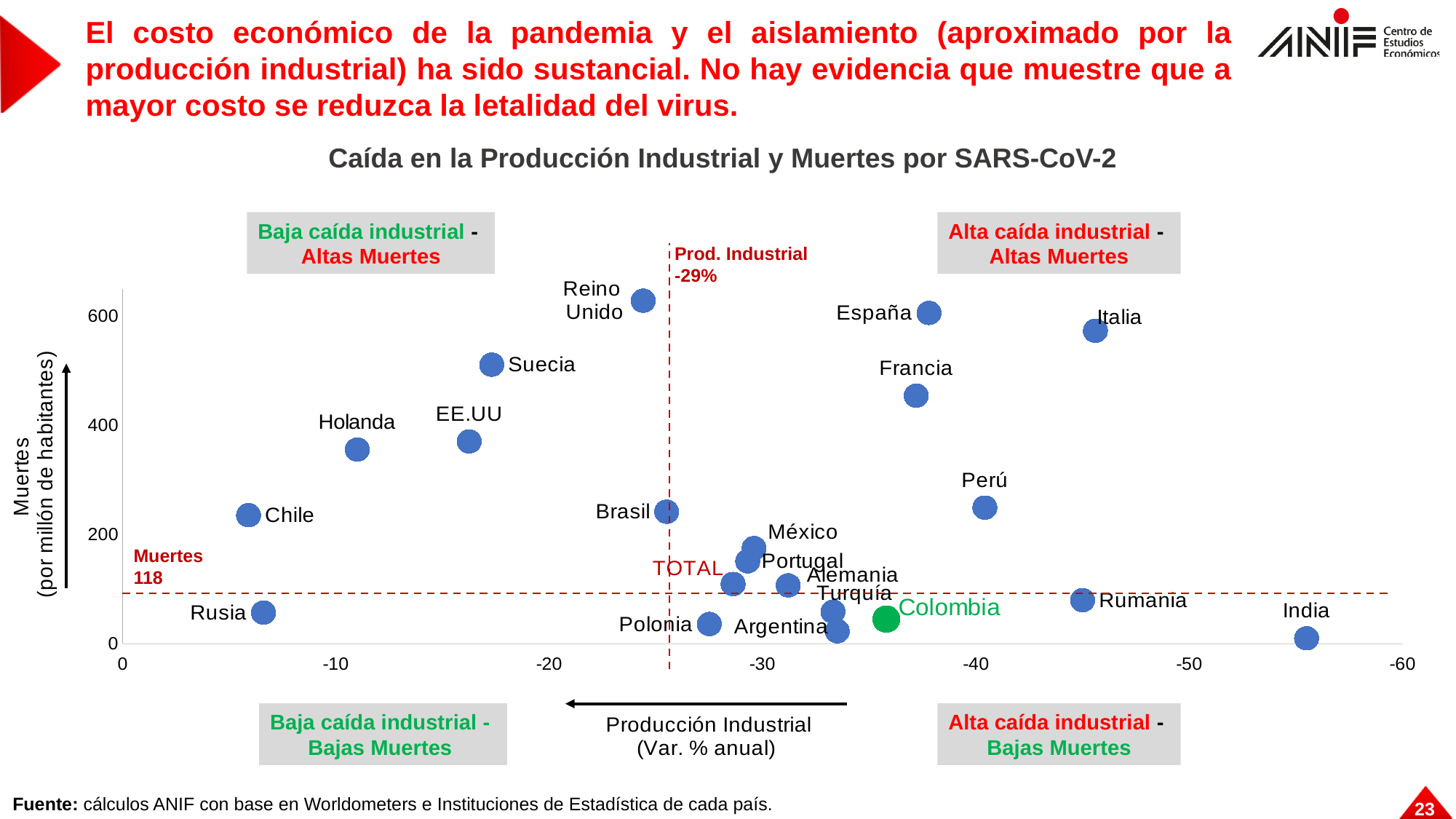
Is the deaths value for Italia greater or less than 400? greater Which country shows the largest fall in industrial production (furthest right on the x axis)? India Which has more deaths per million inhabitants, Italia or Francia? Italia Is the deaths value for Chile greater or less than 200? greater What value is marked by the horizontal dashed reference line labelled 'Muertes'? 118 How many countries are plotted on the chart (excluding the TOTAL point)? 20 Which country has the lowest deaths per million inhabitants on the chart? India What value is marked by the vertical dashed reference line labelled 'Prod. Industrial'? -29% What is the title of the chart? Caída en la Producción Industrial y Muertes por SARS-CoV-2 Which country's point is coloured green instead of blue? Colombia What kind of chart is shown on the slide? Scatter chart Is the deaths value for Holanda greater or less than 400? less